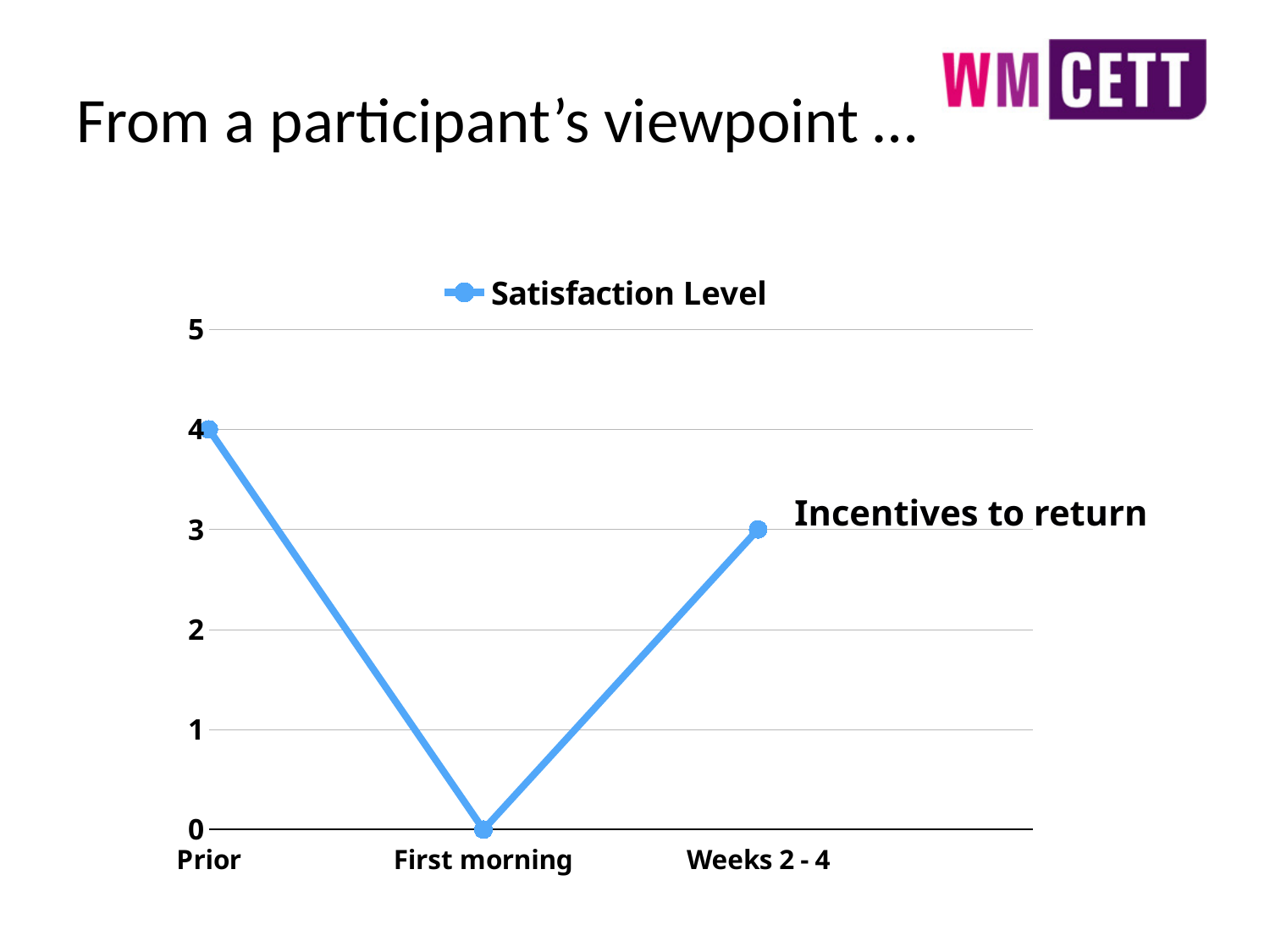
What is the Satisfaction Level for Prior? 4 Does the Satisfaction Level rise or fall from Prior to First morning? Fall What is the Satisfaction Level for Weeks 2 - 4? 3 Which category has the lowest Satisfaction Level? First morning What kind of chart is shown on the slide? Line chart What is the difference in Satisfaction Level between Prior and Weeks 2 - 4? 1 What is the Satisfaction Level for First morning? 0 Which category has the highest Satisfaction Level? Prior How many series does the legend list? 1 Which has a higher Satisfaction Level, Prior or Weeks 2 - 4? Prior What is the name of the series shown in the legend? Satisfaction Level How many categories are shown on the x axis? 3